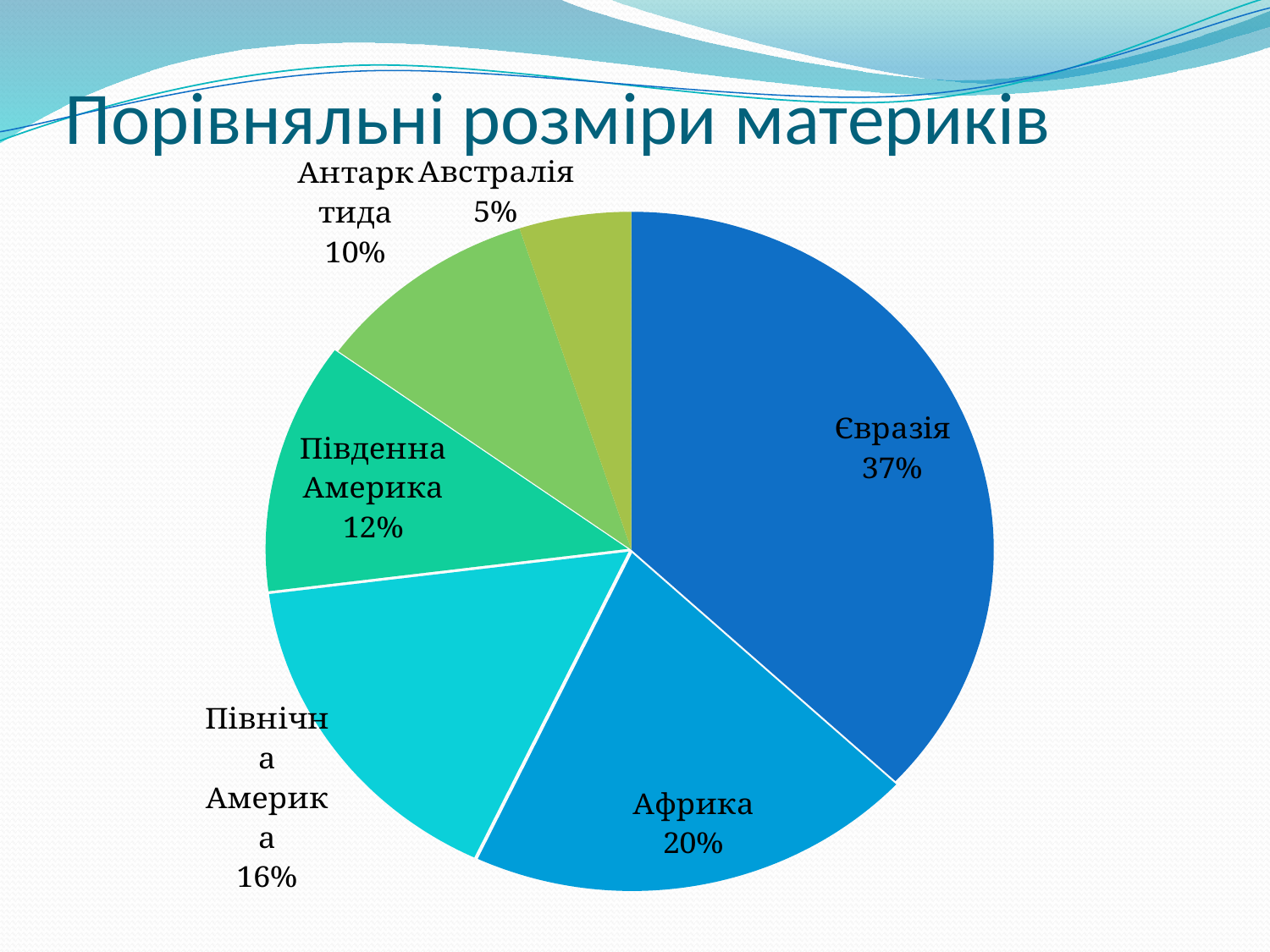
Which continent has the smallest slice of the pie? Австралія How many slices does the pie chart have? 6 What share of the pie does Євразія have? 37% What share is shown for Антарктида? 10% What is the title of the slide? Порівняльні розміри материків Which is larger, the slice for Північна Америка or the slice for Південна Америка? Північна Америка What is the value for Північна Америка? 16% What is the difference in percentage points between Євразія and Африка? 17 What percentage is labelled for Південна Америка? 12% What type of chart is shown on the slide? pie chart What percentage is shown for Африка? 20% Which continent has the largest slice of the pie? Євразія